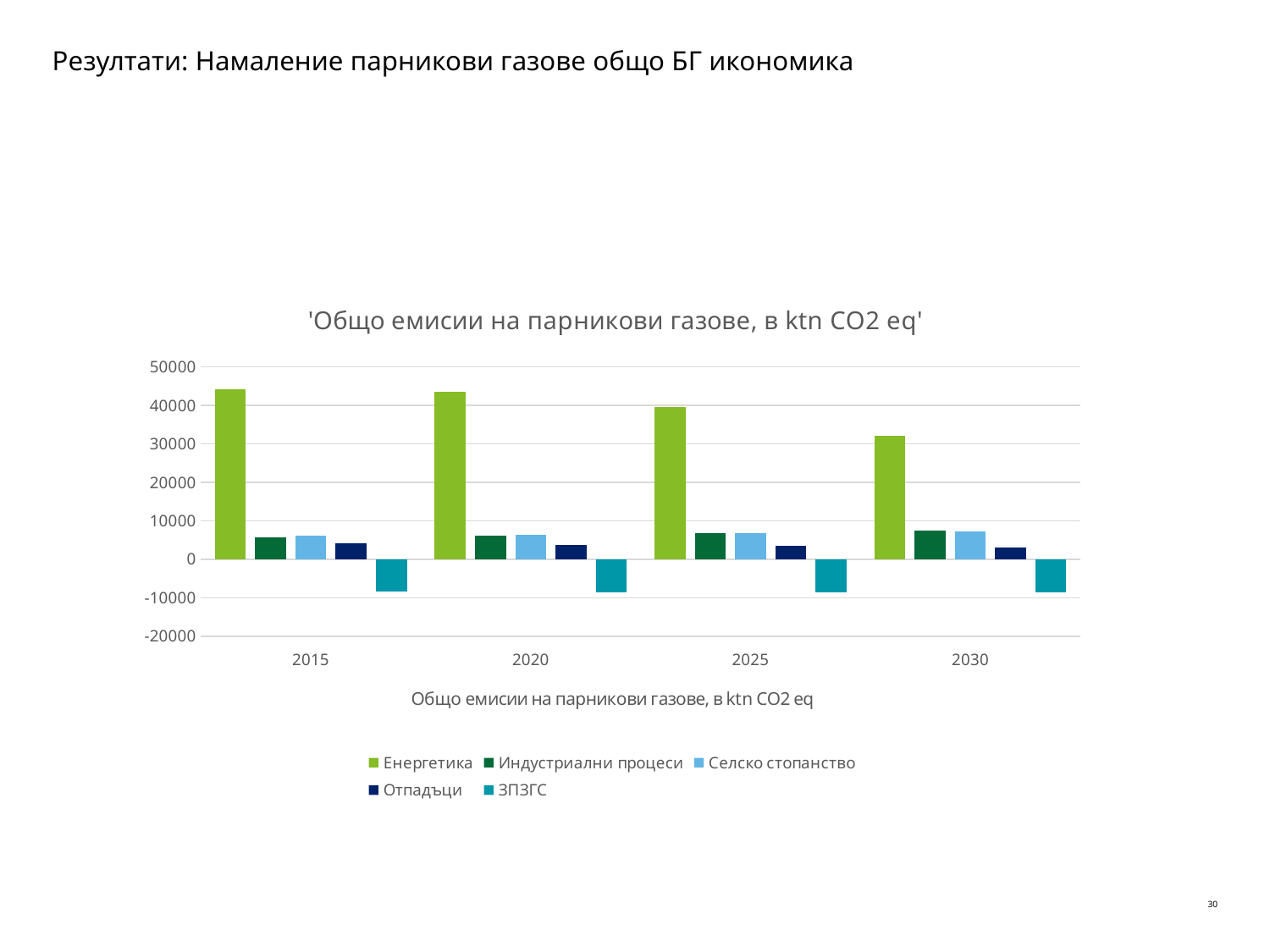
Is the value for Енергетика in 2030 greater or less than 30000? greater Which series has the lowest value in 2015? ЗПЗГС In which year is the value for Енергетика lowest? 2030 How many series does the legend list? 5 Does the value for Енергетика rise or fall from 2015 to 2030? fall What kind of chart is shown on the slide? bar chart Which is larger, the value for Енергетика in 2015 or in 2030? 2015 What is the title of the chart? 'Общо емисии на парникови газове, в ktn CO2 eq' How many years are shown on the x axis? 4 Is the value for ЗПЗГС in 2020 greater or less than 0? less Which is larger, the value for Индустриални процеси in 2015 or in 2030? 2030 Is the value for Енергетика in 2015 greater or less than 40000? greater